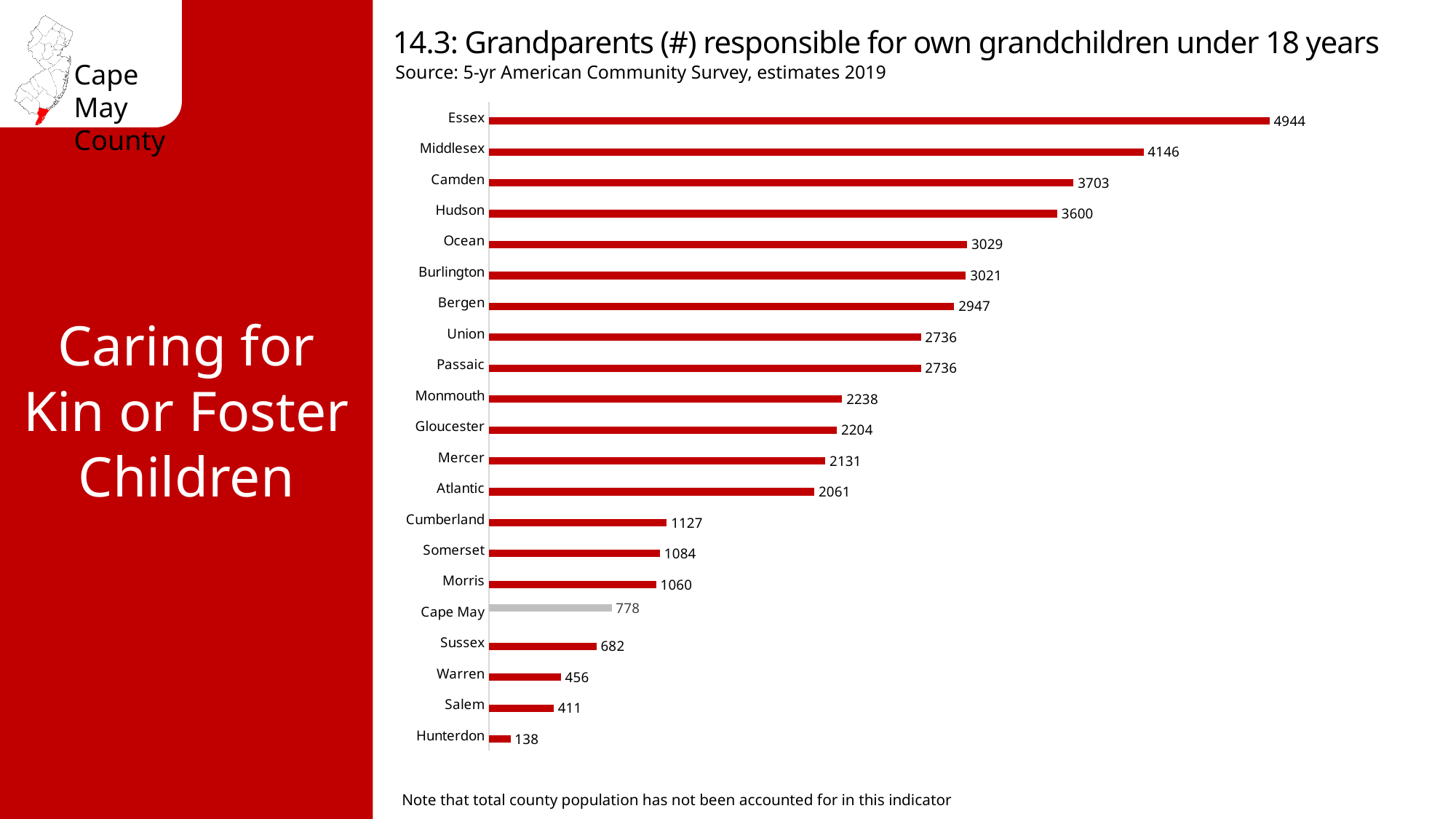
What is the value for Hunterdon? 138 What is the difference between the values for Cape May and Sussex? 96 What is the difference between the values for Essex and Middlesex? 798 How many counties are shown in the chart? 21 What kind of chart is shown on the slide? Bar chart Which is larger, the value for Morris or the value for Cape May? Morris What is the value for Cape May? 778 Which is larger, the value for Camden or the value for Ocean? Camden Which county has the lowest value? Hunterdon Which county has the highest value? Essex Which county's bar is shown in grey instead of red? Cape May What is the value for Essex? 4944